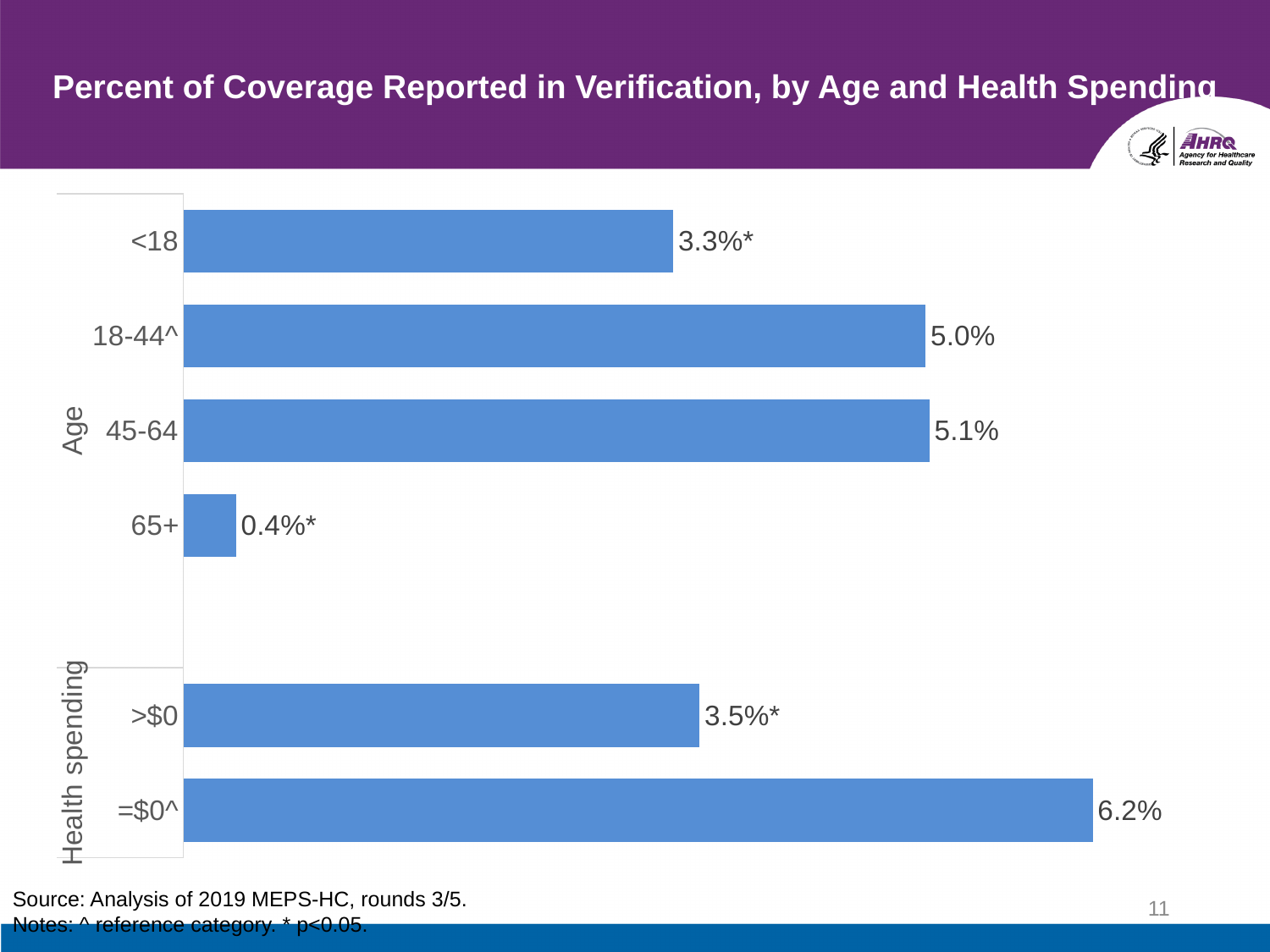
What is the difference between the 45-64 and 65+ age group values? 4.7 percentage points How many categories are plotted in the chart? 6 What is the value for the 18-44^ age group? 5.0% What kind of chart is shown on the slide? Bar chart What is the value for the =$0^ health spending category? 6.2% Which category has the highest value? =$0^ What are the two group labels on the vertical axis? Age and Health spending What is the value for the <18 age group? 3.3%* Which category has the lowest value? 65+ What is the value for the 65+ age group? 0.4%* What is the difference between the =$0^ and >$0 health spending values? 2.7 percentage points Which is larger, the value for <18 or the value for >$0? >$0